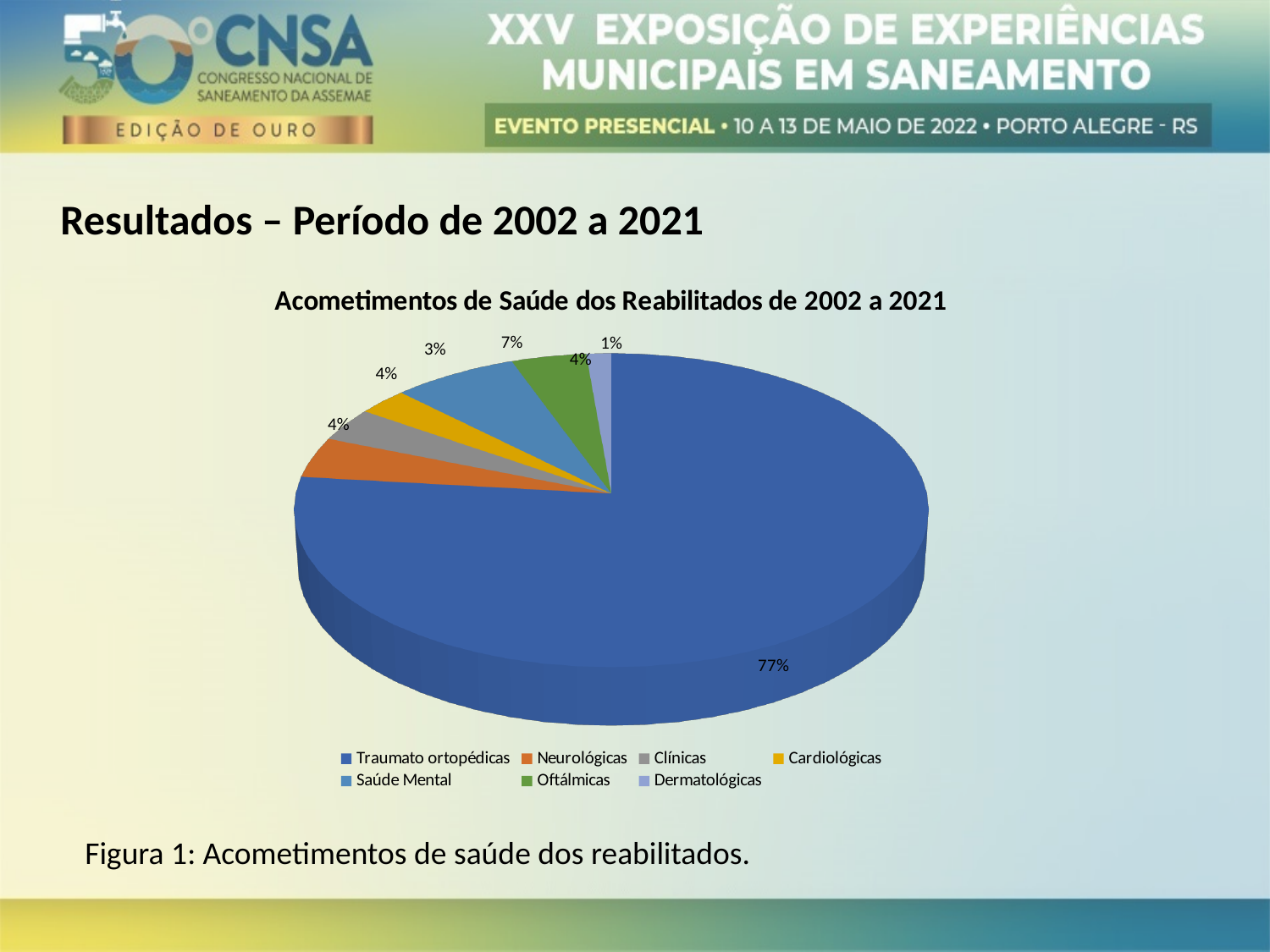
What is the value shown for Cardiológicas? 3% Which category has the largest slice of the pie? Traumato ortopédicas How many categories does the pie chart show? 7 Which is larger, the share for Saúde Mental or the share for Cardiológicas? Saúde Mental What kind of chart is shown on the slide? Pie chart What is the value shown for Saúde Mental? 7% What is the difference in percentage points between Traumato ortopédicas and Saúde Mental? 70 percentage points Which category has the smallest slice of the pie? Dermatológicas What is the value shown for Dermatológicas? 1% What is the title of the chart? Acometimentos de Saúde dos Reabilitados de 2002 a 2021 What share of the pie does Traumato ortopédicas represent? 77% What colour is the slice for Traumato ortopédicas? Blue